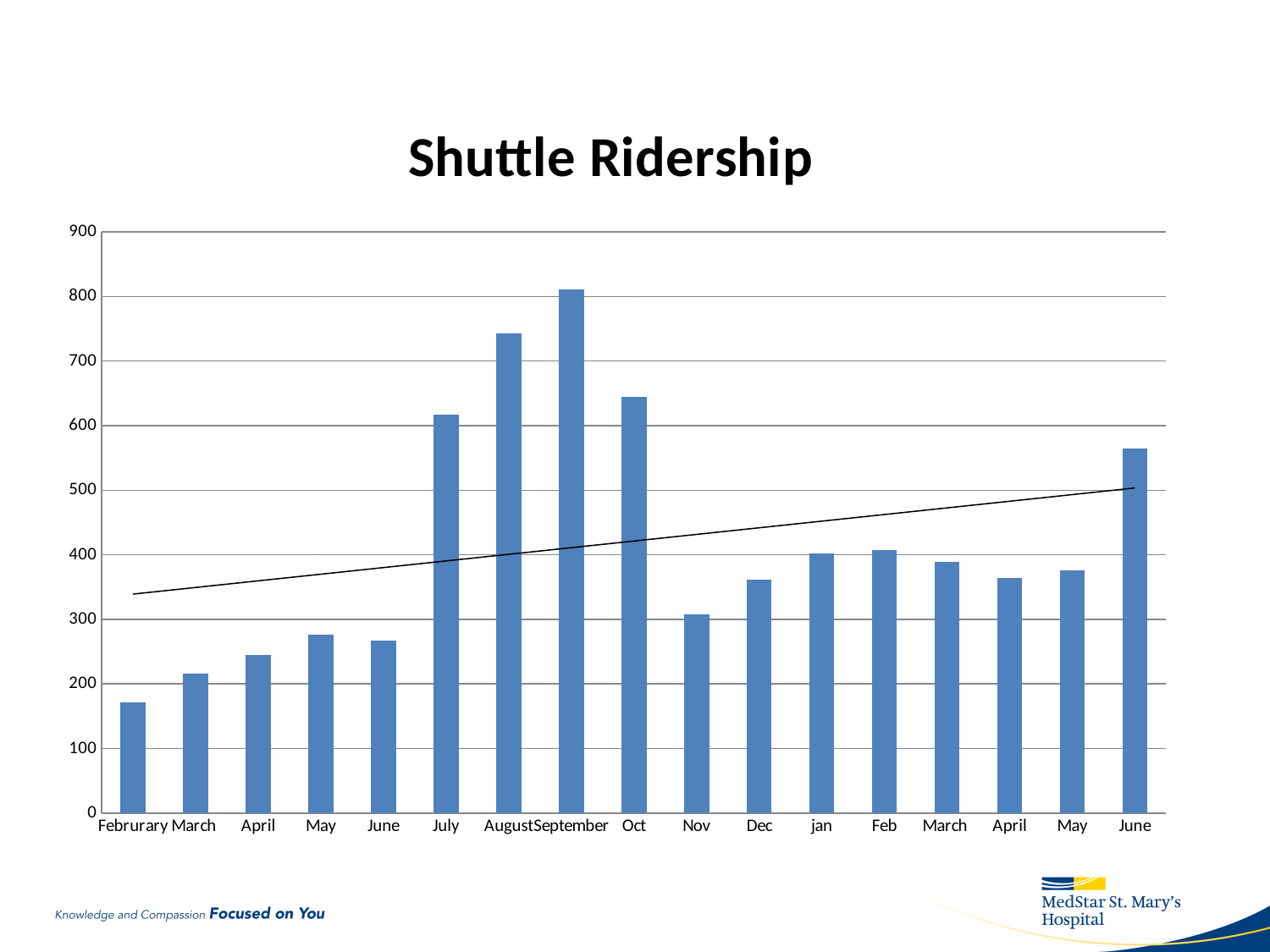
Is the value for Dec greater or less than 400? less Which month has the lowest shuttle ridership? February Is the value for September greater or less than 800? greater Which is larger, the value for August or the value for Oct? August Is the value for August greater or less than 700? greater How many bars are plotted in the chart? 17 What is the title of the chart? Shuttle Ridership What kind of chart is shown on the slide? bar chart Do the values rise or fall from February through September? rise Which month has the highest shuttle ridership? September